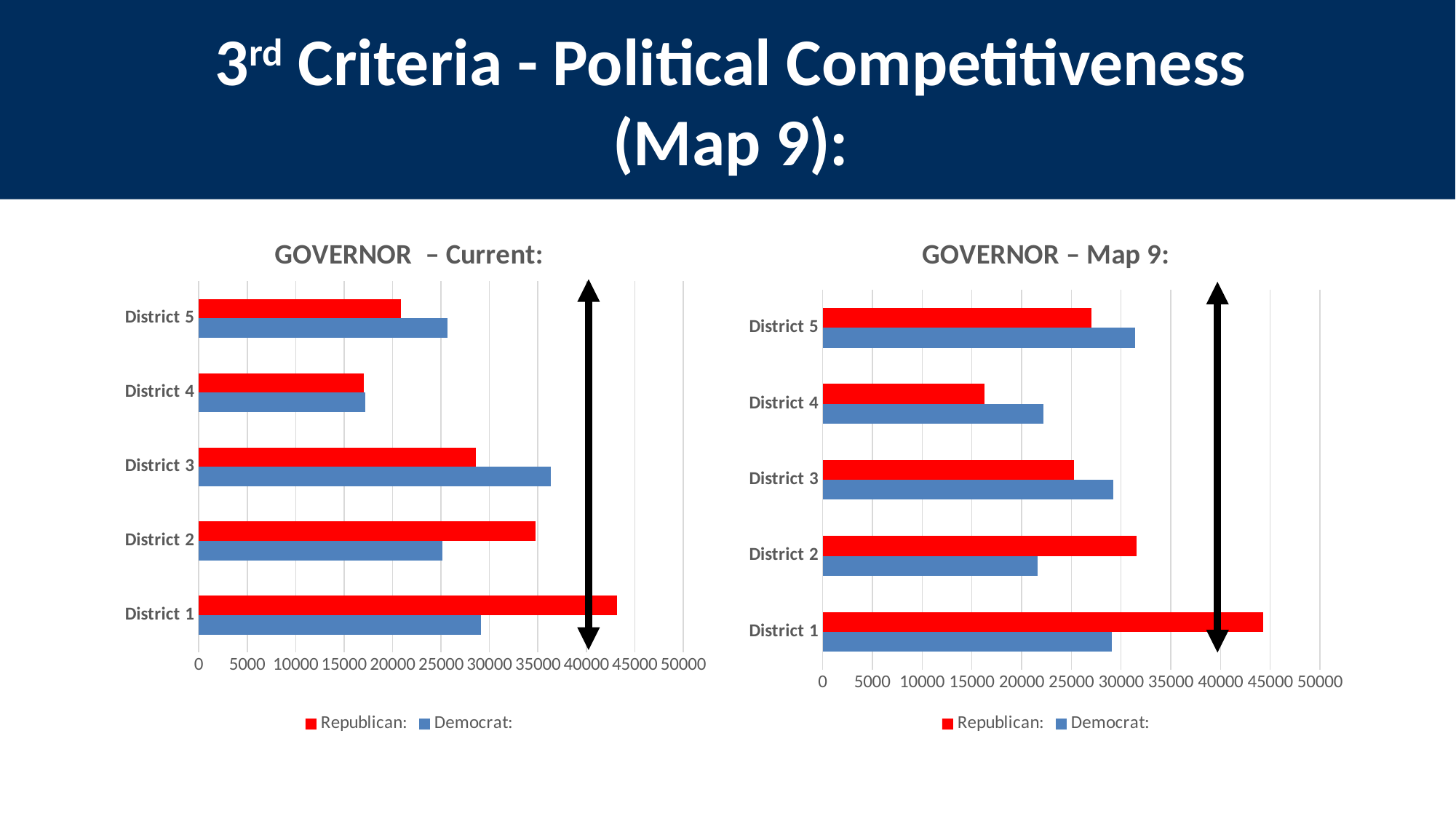
On the GOVERNOR – Current chart, which district has the lowest Democrat value? District 4 How many series does the legend of the GOVERNOR – Current chart list? 2 On the GOVERNOR – Current chart, is the Republican value for District 1 greater or less than 40000? greater On the GOVERNOR – Current chart, which is larger for District 3, the Republican value or the Democrat value? Democrat What kind of chart is the GOVERNOR – Current chart? Bar chart Which colour represents the Democrat series on the GOVERNOR – Map 9 chart? Blue On the GOVERNOR – Current chart, which district has the highest Republican value? District 1 On the GOVERNOR – Map 9 chart, is the Democrat value for District 4 greater or less than 25000? less On the GOVERNOR – Map 9 chart, which district has the highest Republican value? District 1 On the GOVERNOR – Map 9 chart, which district has the lowest Republican value? District 4 How many districts are shown on the GOVERNOR – Map 9 chart? 5 On the GOVERNOR – Map 9 chart, which is larger for District 2, the Republican value or the Democrat value? Republican